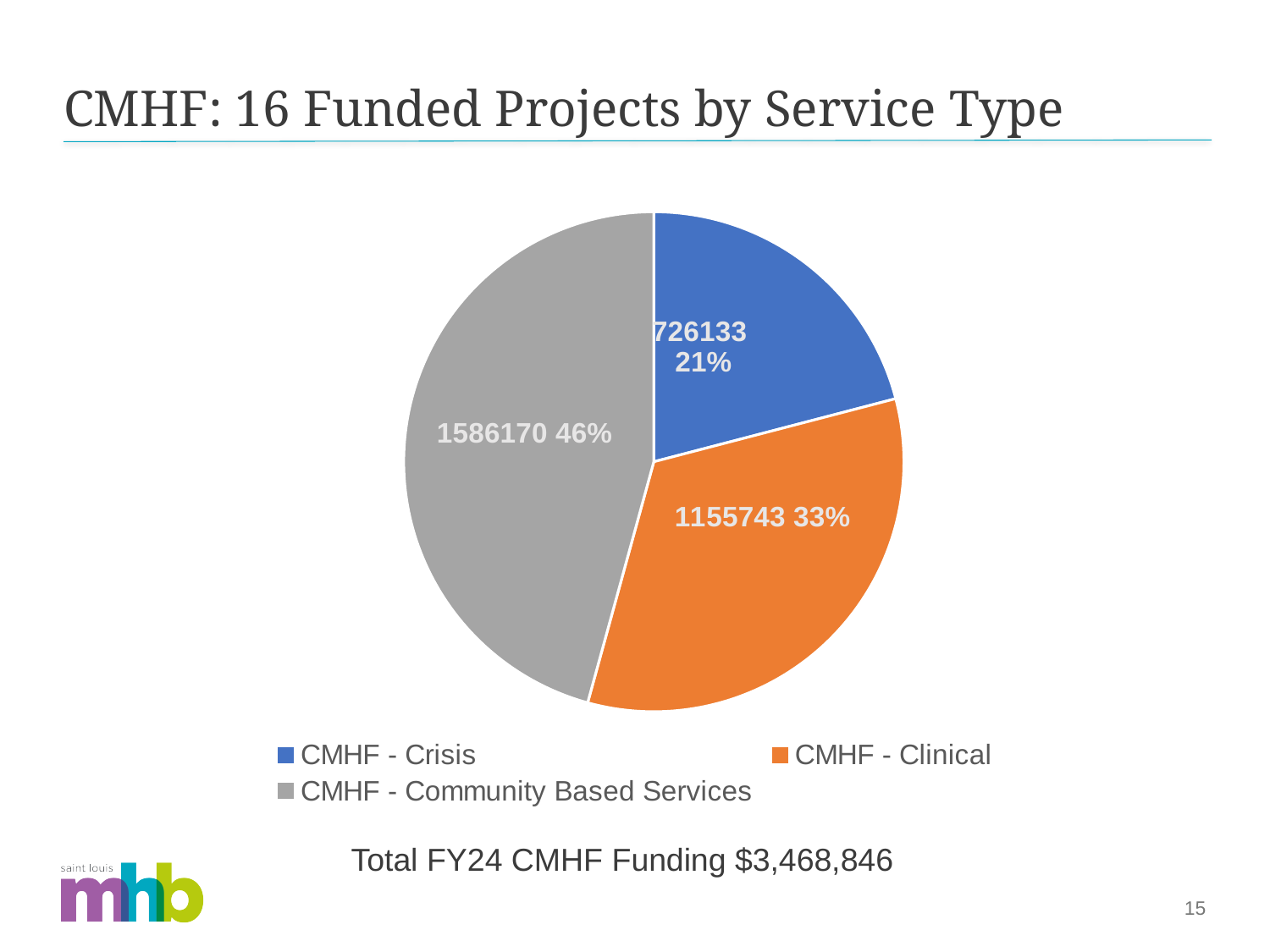
What is the difference between the values for CMHF - Community Based Services and CMHF - Clinical? 430427 Which category has the smallest slice? CMHF - Crisis Which is larger, CMHF - Clinical or CMHF - Crisis? CMHF - Clinical What share of the pie does CMHF - Community Based Services represent? 46% What share of the pie does CMHF - Clinical represent? 33% What is the value for CMHF - Community Based Services? 1586170 What kind of chart is shown on the slide? pie chart Which category has the largest slice? CMHF - Community Based Services How many categories does the pie chart have? 3 What is the value for CMHF - Crisis? 726133 What colour is the CMHF - Clinical slice? orange What is the value for CMHF - Clinical? 1155743